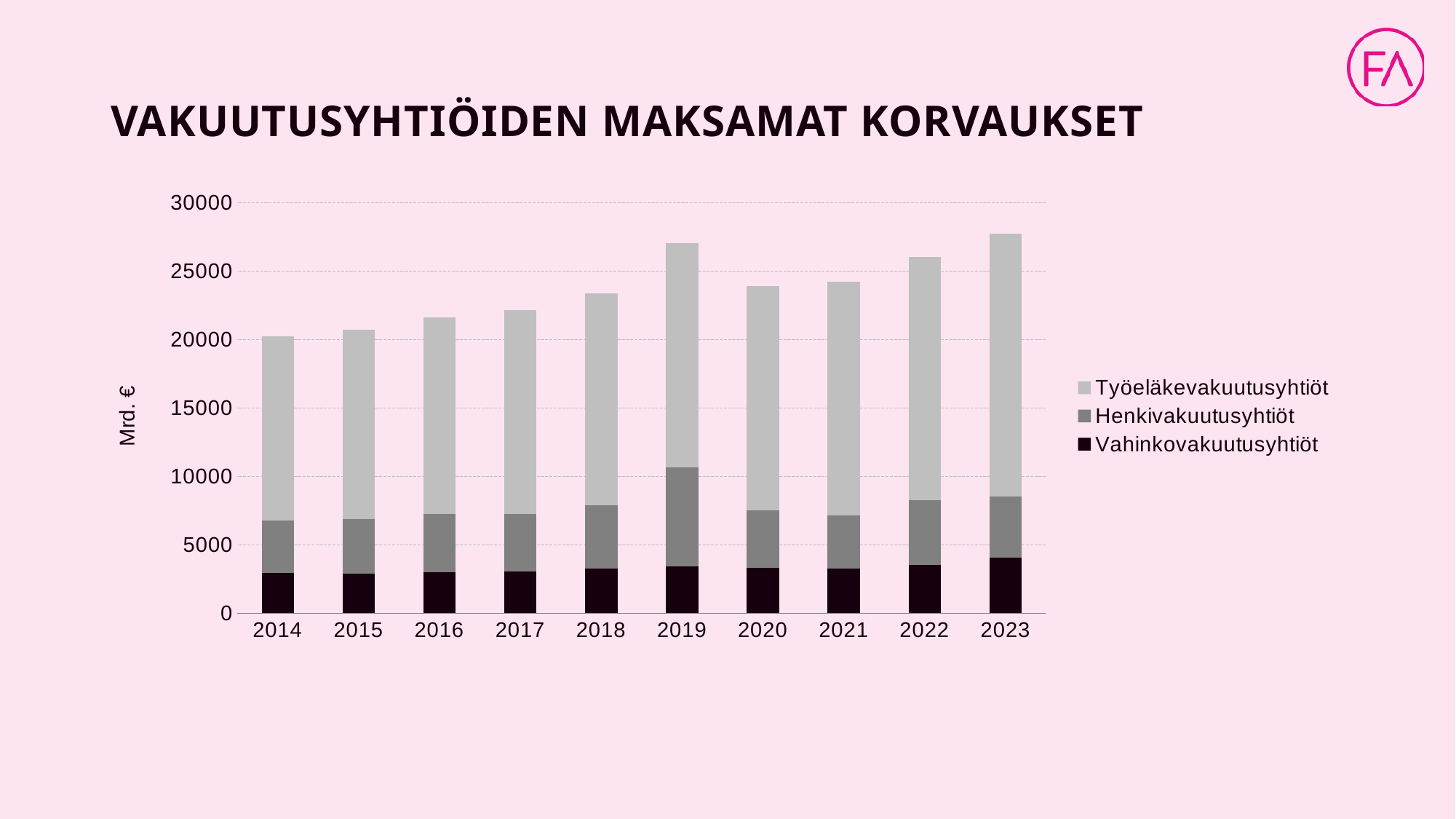
What is the title of the chart on the slide? VAKUUTUSYHTIÖIDEN MAKSAMAT KORVAUKSET What kind of chart is shown on the slide? Stacked bar chart How many years are shown on the x axis of the chart? 10 Is the Vahinkovakuutusyhtiöt value for 2023 greater or less than 5000? less Which year has the largest Henkivakuutusyhtiöt segment? 2019 What is the label on the vertical axis of the chart? Mrd. € How many series does the chart's legend list? 3 Is the total value of the bar for 2019 greater or less than 25000? greater Is the total value of the bar for 2014 greater or less than 25000? less Do the total bar heights generally rise or fall from 2014 to 2023? rise Which bar is taller in total, 2019 or 2020? 2019